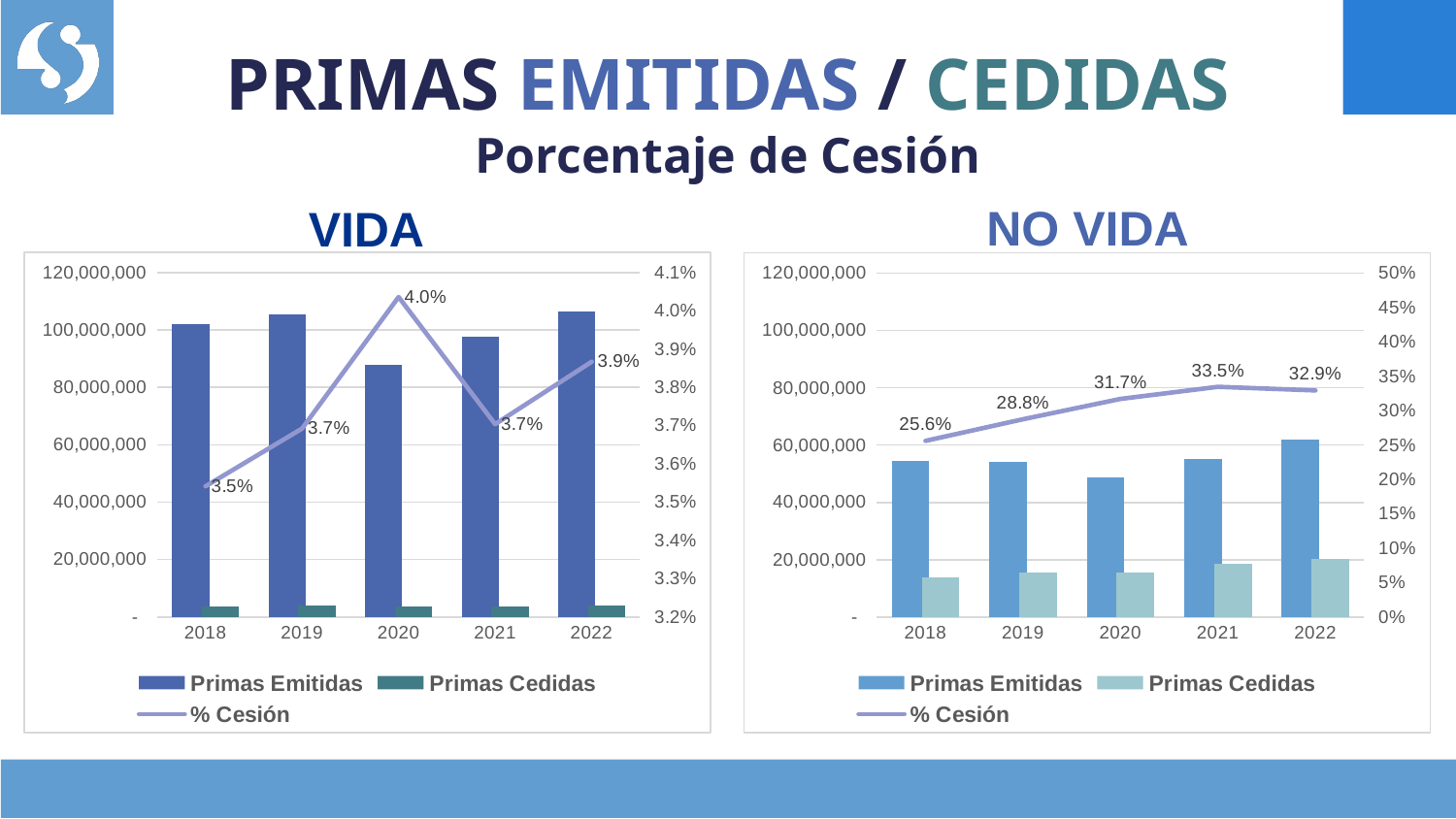
In the NO VIDA chart, what is the difference in % Cesión between 2022 and 2018? 7.3 percentage points How many years are shown on the x axis of the NO VIDA chart? 5 In the NO VIDA chart, which year has the highest % Cesión? 2021 In the NO VIDA chart, does the % Cesión rise or fall from 2018 to 2021? rise What kind of chart is the NO VIDA chart? Combination bar and line chart In the VIDA chart, is the Primas Emitidas value for 2020 greater or less than 100,000,000? less How many series does the legend of the VIDA chart list? 3 In the NO VIDA chart, what is the % Cesión value for 2018? 25.6% In the VIDA chart, which year has the lowest % Cesión? 2018 In the VIDA chart, is the % Cesión higher in 2022 or in 2021? 2022 In the NO VIDA chart, is the Primas Emitidas value for 2020 greater or less than 60,000,000? less In the VIDA chart, what is the % Cesión value for 2020? 4.0%